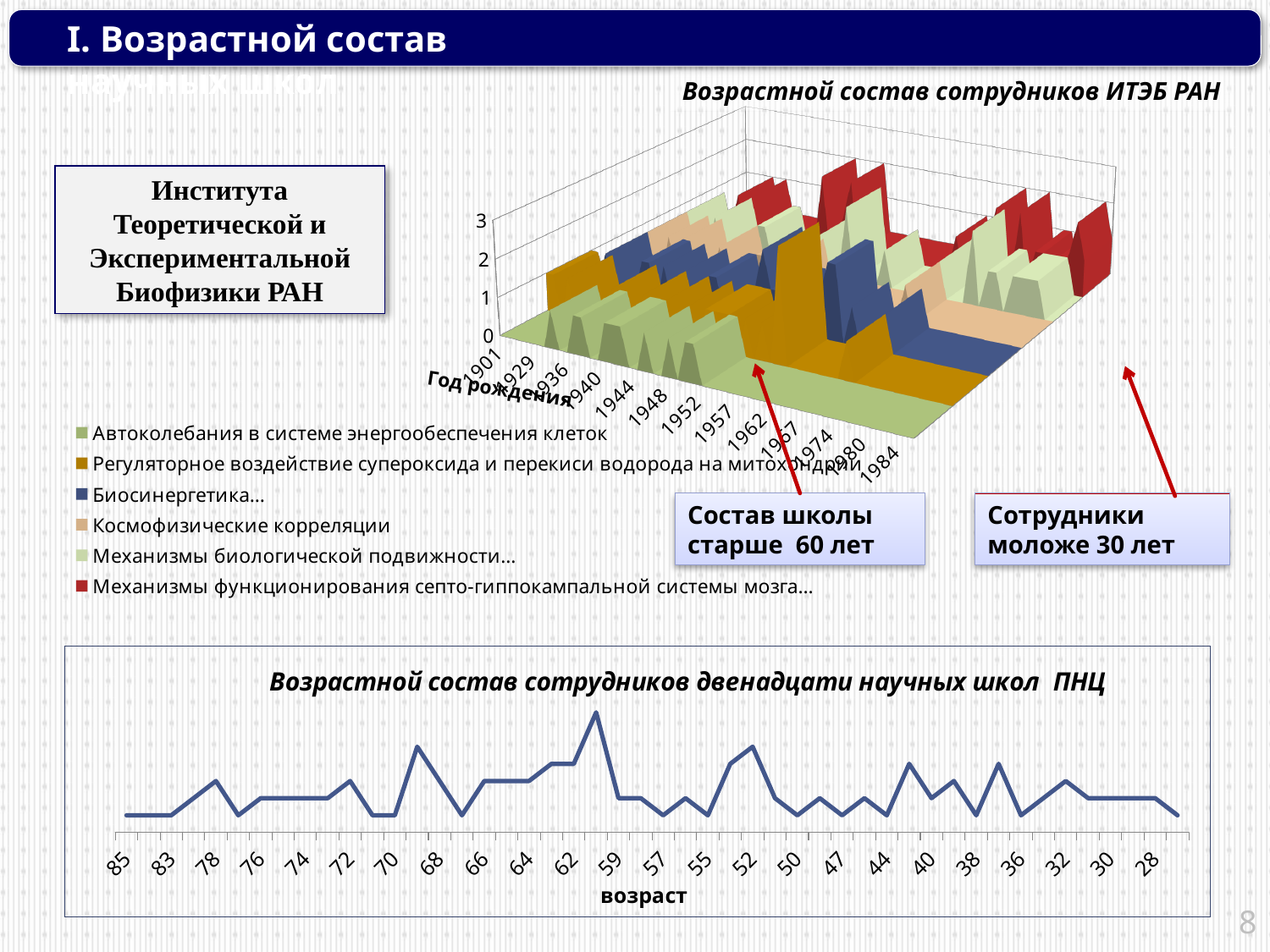
What is the title of the horizontal axis of the bottom chart "Возрастной состав сотрудников двенадцати научных школ ПНЦ"? возраст How many series does the legend of the top chart "Возрастной состав сотрудников ИТЭБ РАН" list? 6 What is the last age label on the horizontal axis of the bottom chart "Возрастной состав сотрудников двенадцати научных школ ПНЦ"? 28 How many tick labels are shown on the horizontal axis of the bottom chart "Возрастной состав сотрудников двенадцати научных школ ПНЦ"? 24 What kind of chart is the bottom chart titled "Возрастной состав сотрудников двенадцати научных школ ПНЦ"? Line chart How many year labels are shown on the "Год рождения" axis of the top chart "Возрастной состав сотрудников ИТЭБ РАН"? 13 What is the highest value shown on the vertical axis of the top chart "Возрастной состав сотрудников ИТЭБ РАН"? 3 What is the first year label on the horizontal axis of the top chart "Возрастной состав сотрудников ИТЭБ РАН"? 1901